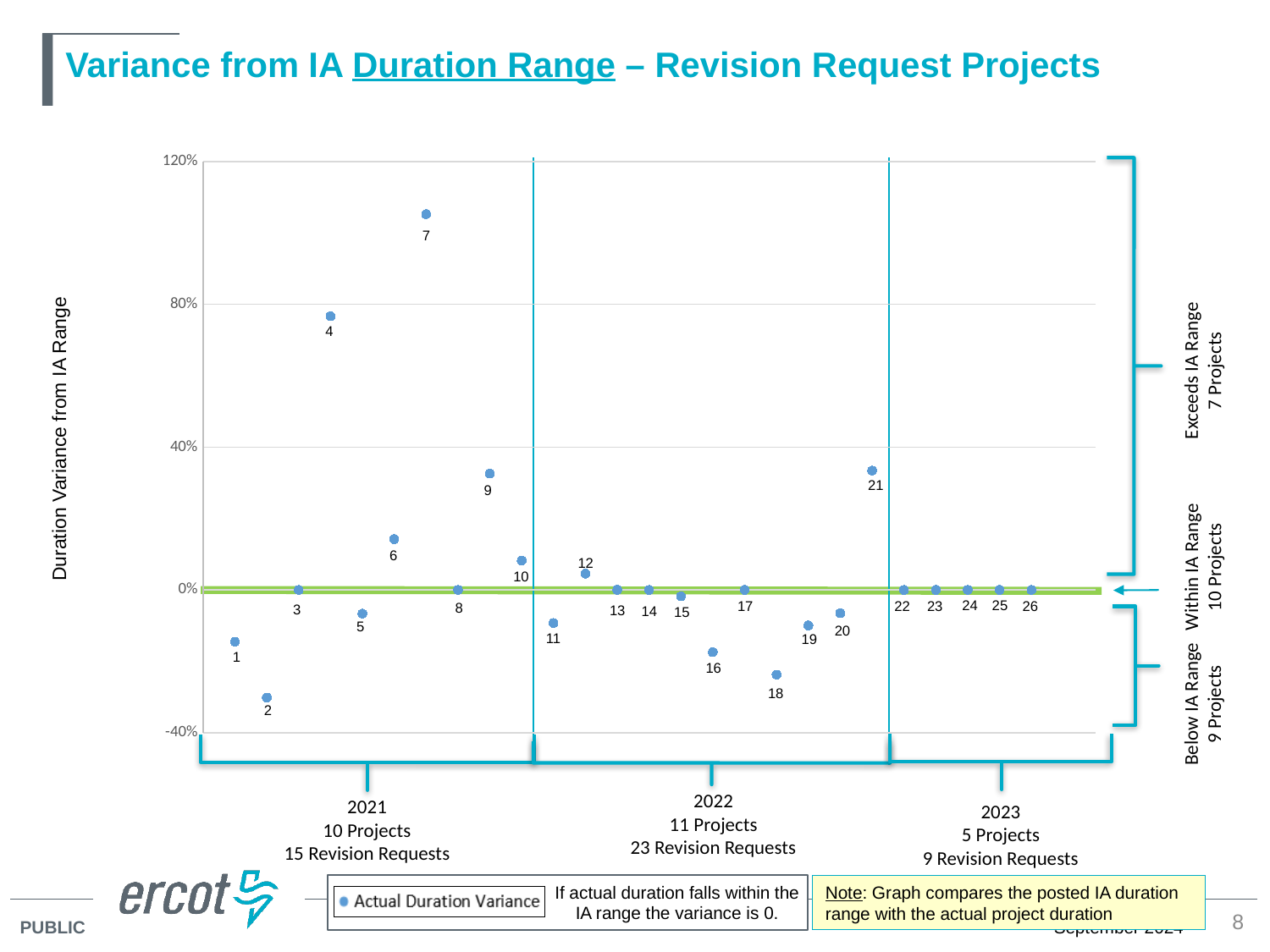
Which numbered project has the lowest duration variance from IA range? 2 Is the duration variance for project 21 greater or less than 40%? less Is the duration variance for project 2 greater or less than -40%? greater Which has the larger duration variance, project 4 or project 7? project 7 What is the title of the vertical axis? Duration Variance from IA Range Is the duration variance for project 7 greater or less than 80%? greater What is the legend entry for the plotted series? Actual Duration Variance Which numbered project has the highest duration variance from IA range? 7 How many data points are plotted on the chart? 26 How many series does the legend list? 1 What kind of chart is shown on the slide? scatter chart